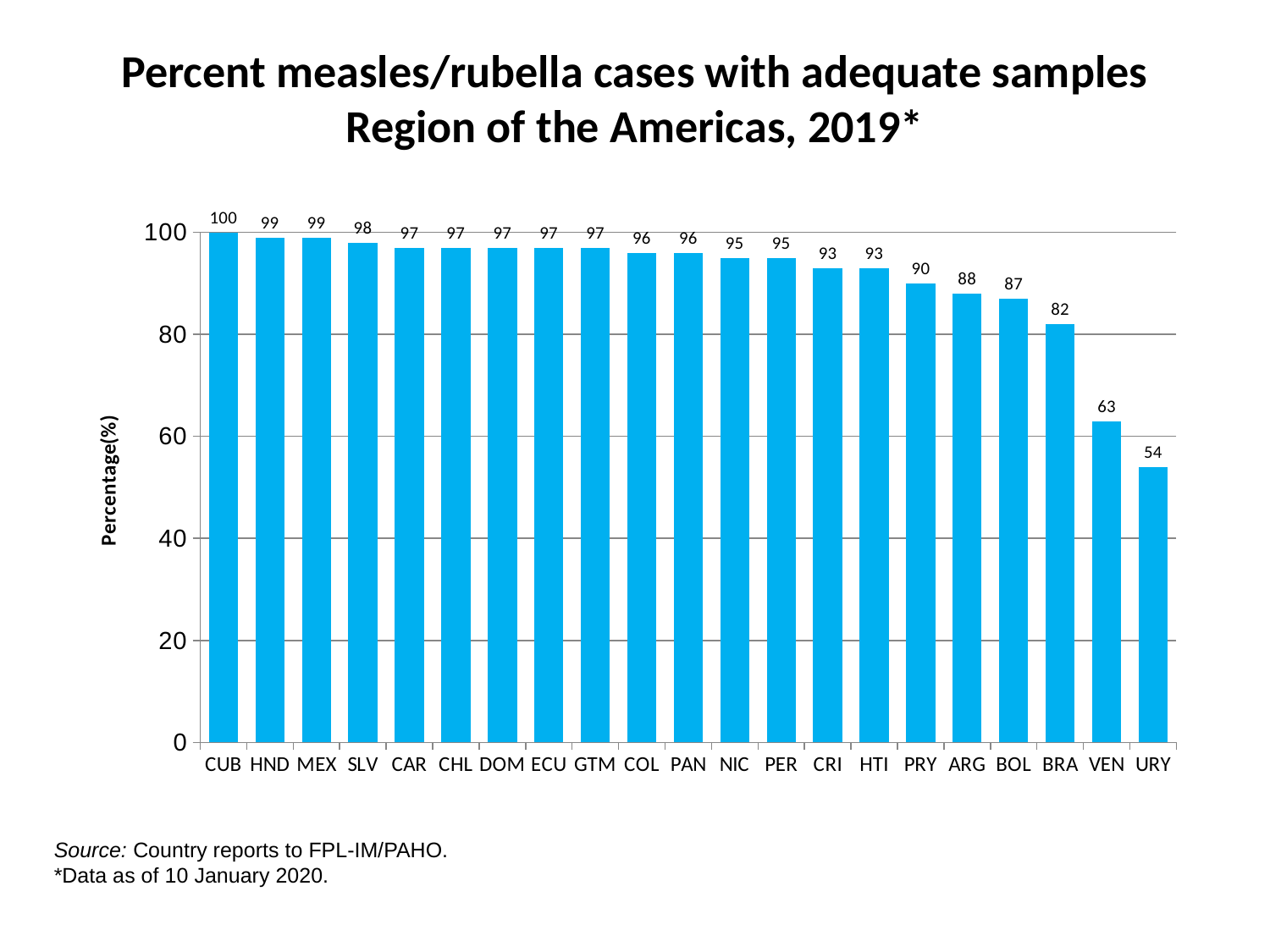
Which country has the lowest value? URY Which has a larger value, ARG or VEN? ARG What is the value for CUB? 100 What is the value for URY? 54 What is the value for BRA? 82 How many countries are shown on the x axis? 21 What is the difference between the values for VEN and URY? 9 Which country has the highest value? CUB Do the values rise or fall from left to right along the x axis? Fall What is the value for PRY? 90 What is the difference between the values for CUB and BRA? 18 What kind of chart is this? Bar chart